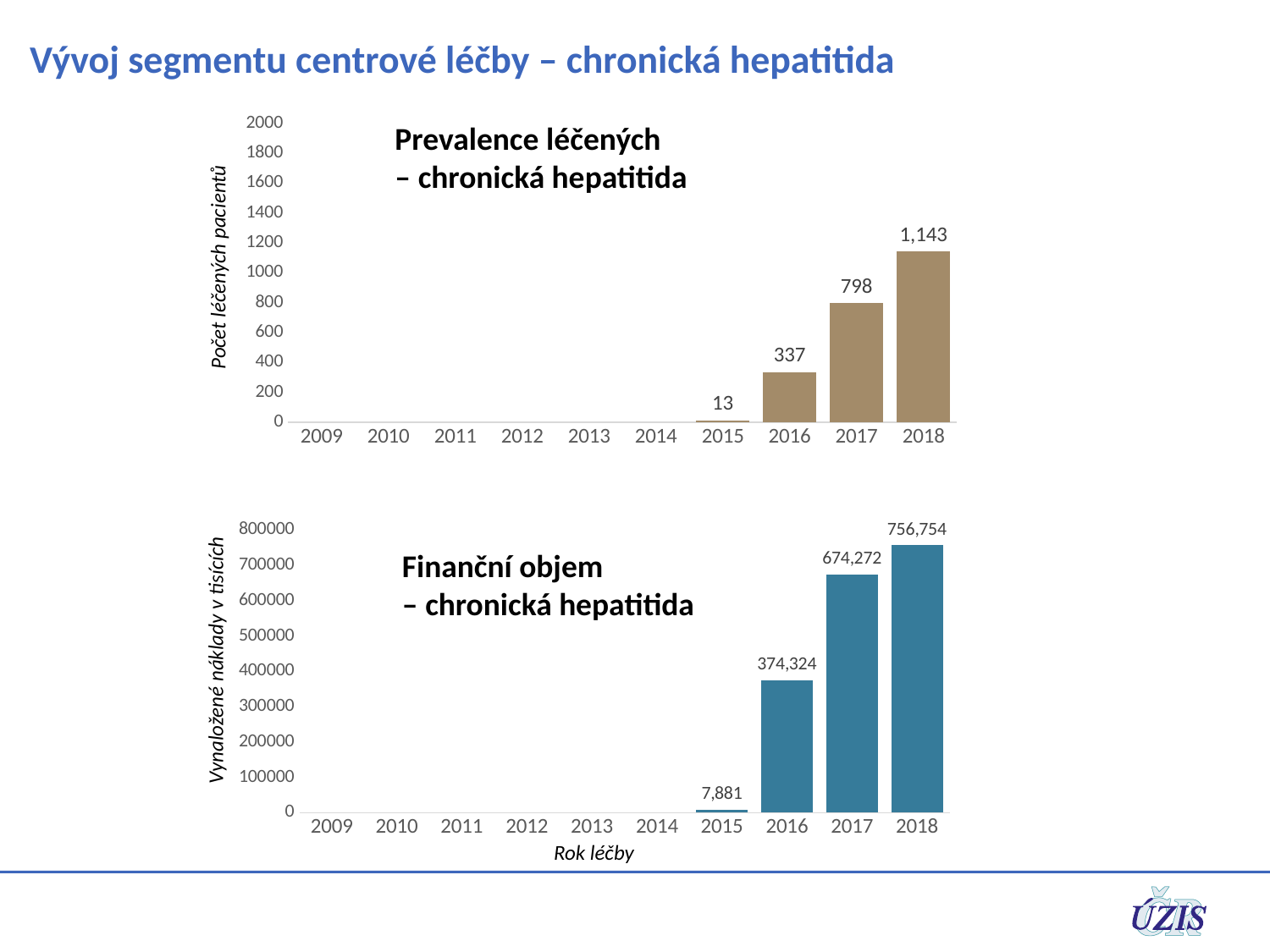
In the 'Finanční objem – chronická hepatitida' chart, do the values rise or fall from 2015 to 2018? rise In the 'Finanční objem – chronická hepatitida' chart, which of 2017 or 2016 has the larger value? 2017 In the 'Finanční objem – chronická hepatitida' chart, how many years are shown on the x axis? 10 In the 'Prevalence léčených – chronická hepatitida' chart, which year has the highest value? 2018 In the 'Finanční objem – chronická hepatitida' chart, what is the difference between the values for 2017 and 2016? 299,948 In the 'Prevalence léčených – chronická hepatitida' chart, what is the value for 2017? 798 In the 'Prevalence léčených – chronická hepatitida' chart, is the value for 2016 greater or less than 400? less In the 'Finanční objem – chronická hepatitida' chart, what is the value for 2016? 374,324 In the 'Prevalence léčených – chronická hepatitida' chart, what is the value for 2015? 13 What kind of chart is the 'Prevalence léčených – chronická hepatitida' chart? bar chart In the 'Prevalence léčených – chronická hepatitida' chart, what is the difference between the values for 2018 and 2017? 345 In the 'Finanční objem – chronická hepatitida' chart, what is the value for 2018? 756,754